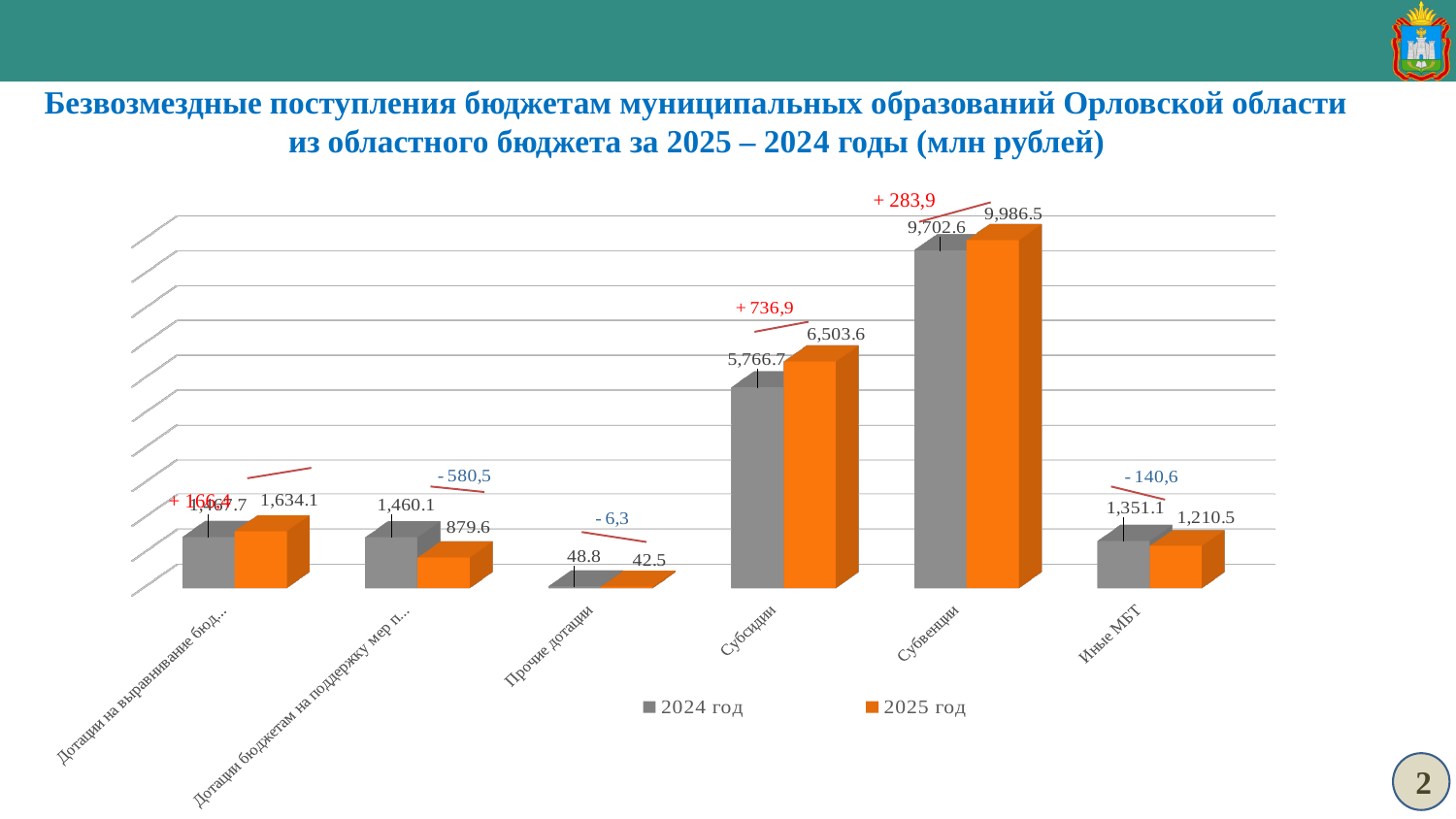
For Иные МБТ, which is larger: the 2024 год value or the 2025 год value? 2024 год Which category has the lowest value in 2024 год? Прочие дотации What type of chart is shown on the slide? bar chart How many categories are shown on the x axis? 6 What is the value for Прочие дотации in 2025 год? 42.5 Which category has the highest value in 2025 год? Субвенции How many series does the legend list? 2 What is the value for Иные МБТ in 2024 год? 1,351.1 Which colour represents the 2025 год series in the legend? orange What is the value for Субсидии in 2024 год? 5,766.7 What is the difference between the 2025 год and 2024 год values for Субсидии? 736.9 What is the value for Субвенции in 2025 год? 9,986.5